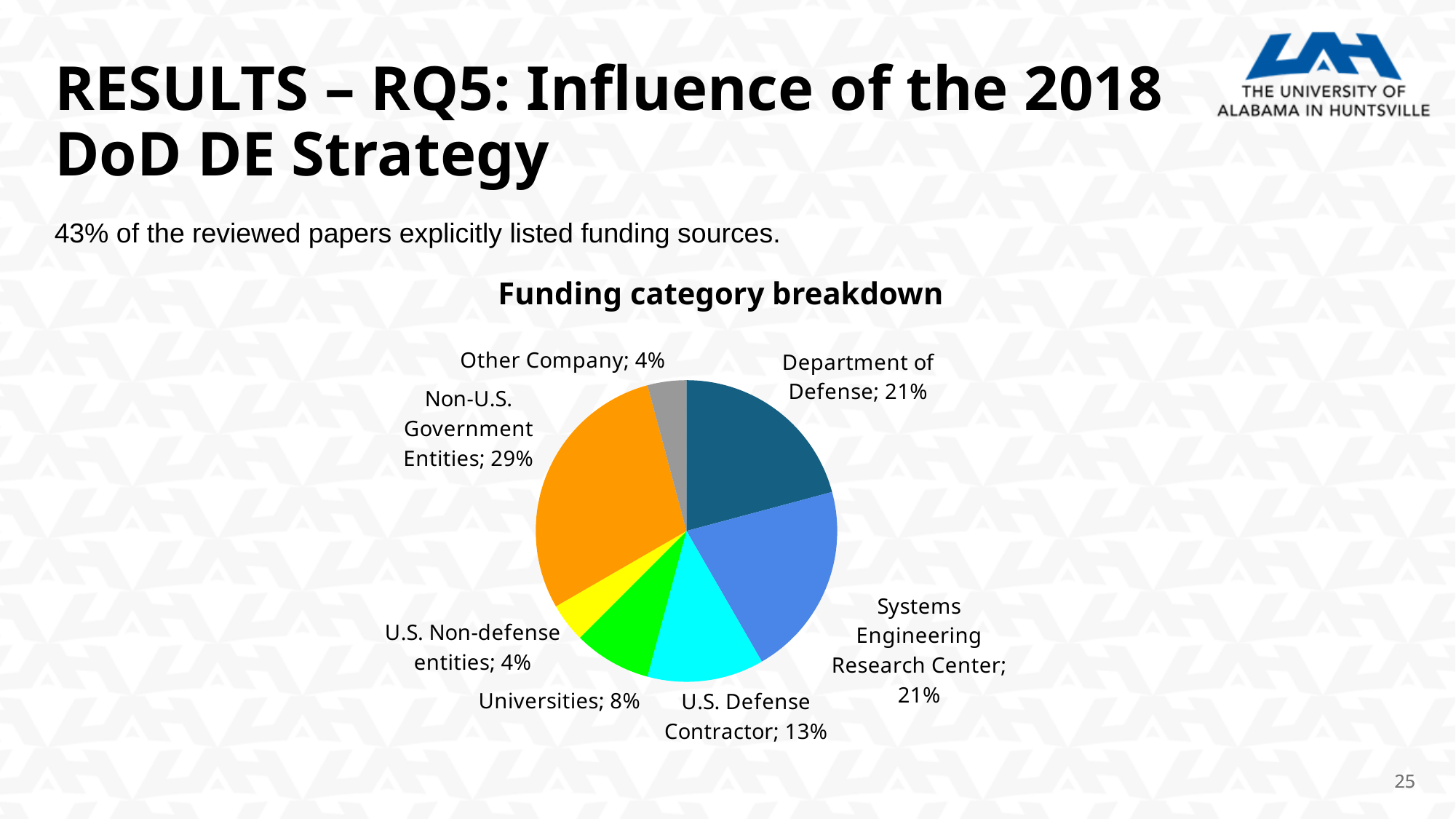
Which category has the largest share of the pie? Non-U.S. Government Entities What is the difference between the shares of Non-U.S. Government Entities and U.S. Defense Contractor? 16% What type of chart is shown on the slide? pie chart What is the value for U.S. Defense Contractor? 13% Which is larger, the share for Universities or the share for U.S. Non-defense entities? Universities What is the value for Other Company? 4% What is the value for Universities? 8% What is the title of the chart? Funding category breakdown How many categories does the pie chart show? 7 What is the value for Department of Defense? 21% What share of the pie is Non-U.S. Government Entities? 29% What colour is the Non-U.S. Government Entities slice? orange